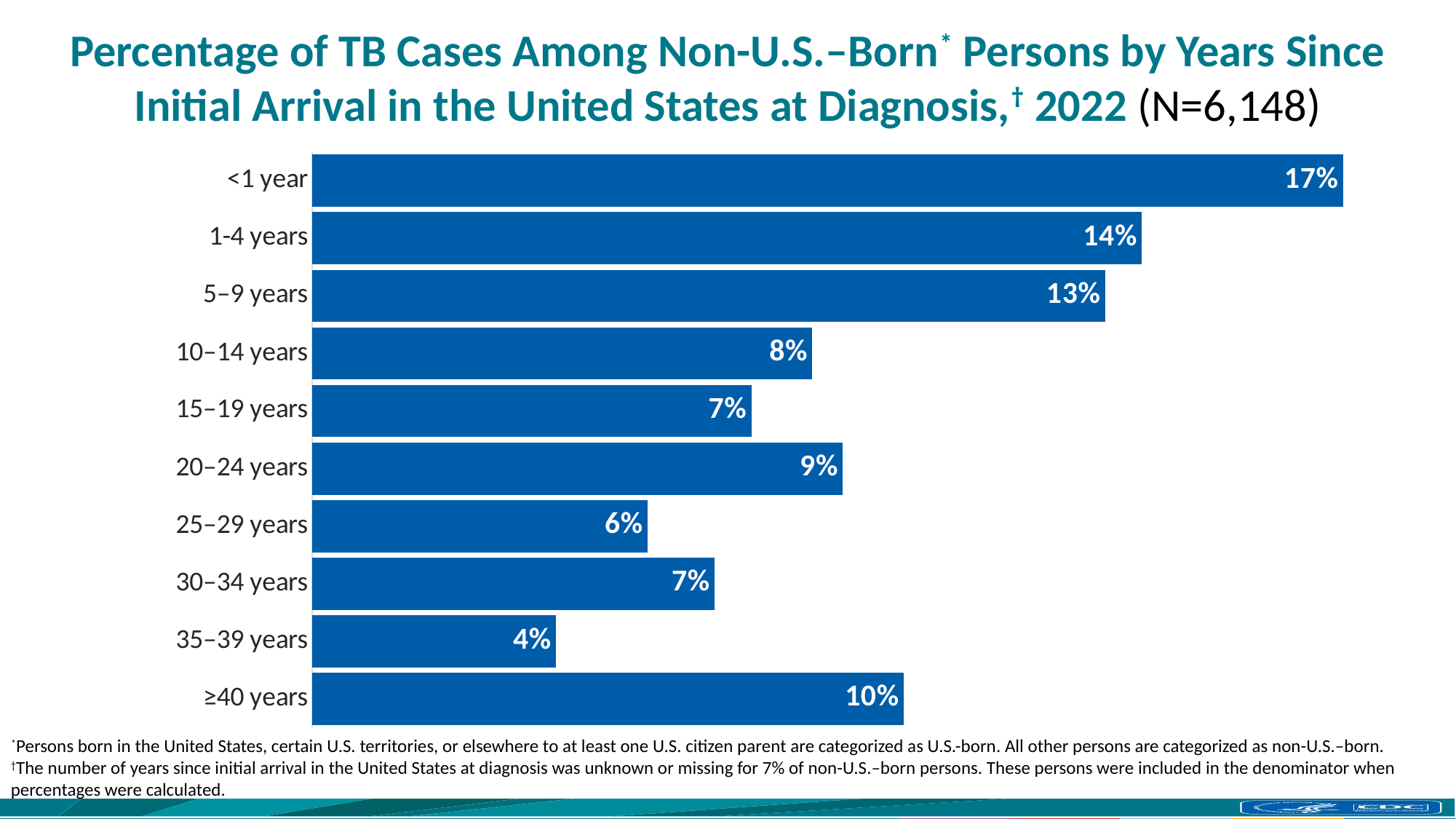
What type of chart is shown on the slide? Bar chart Which category has a larger percentage, 25–29 years or 30–34 years? 30–34 years What percentage of TB cases is shown for the <1 year category? 17% What percentage of TB cases is shown for the ≥40 years category? 10% How many years-since-arrival categories are shown in the chart? 10 Which years-since-arrival category has the lowest percentage of TB cases? 35–39 years What is the total number of cases (N) stated in the chart title? 6,148 What percentage of TB cases is shown for the 20–24 years category? 9% Which category has a larger percentage, ≥40 years or 20–24 years? ≥40 years Which years-since-arrival category has the highest percentage of TB cases? <1 year What is the difference in percentage points between the 5–9 years and 10–14 years categories? 5 What is the difference in percentage points between the <1 year and 1-4 years categories? 3